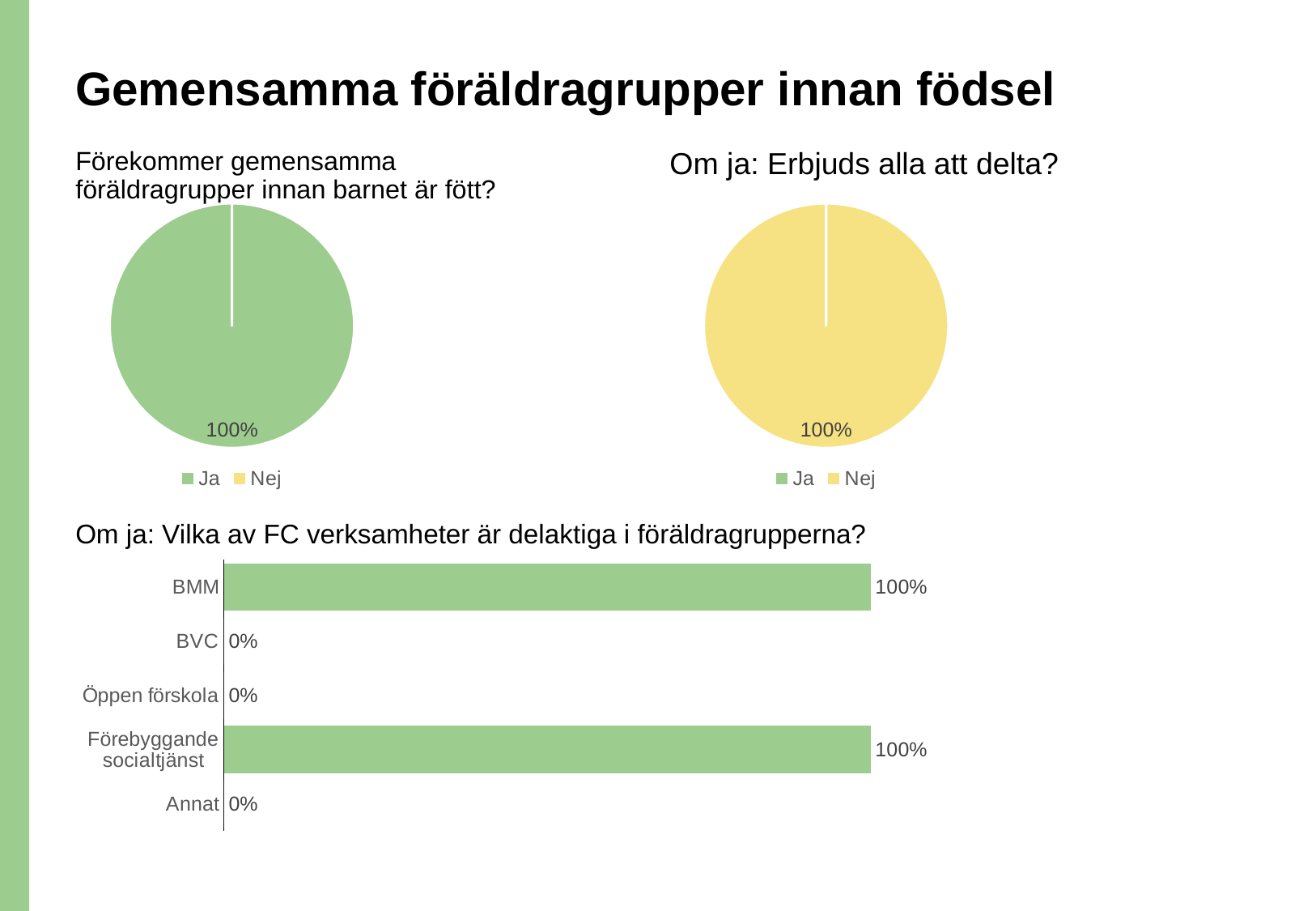
In the pie chart titled "Förekommer gemensamma föräldragrupper innan barnet är fött?", what share does the Ja slice have? 100% In the pie chart titled "Förekommer gemensamma föräldragrupper innan barnet är fött?", how many entries does the legend list? 2 What kind of chart is the chart titled "Om ja: Erbjuds alla att delta?"? pie chart In the bar chart titled "Om ja: Vilka av FC verksamheter är delaktiga i föräldragrupperna?", what is the difference between BMM and Annat? 100% In the pie chart titled "Om ja: Erbjuds alla att delta?", what share does the Nej slice have? 100% In the bar chart titled "Om ja: Vilka av FC verksamheter är delaktiga i föräldragrupperna?", how many categories are shown? 5 In the pie chart titled "Om ja: Erbjuds alla att delta?", which category makes up the whole pie? Nej In the bar chart titled "Om ja: Vilka av FC verksamheter är delaktiga i föräldragrupperna?", what is the value for BMM? 100% What kind of chart is the chart titled "Om ja: Vilka av FC verksamheter är delaktiga i föräldragrupperna?"? bar chart In the bar chart titled "Om ja: Vilka av FC verksamheter är delaktiga i föräldragrupperna?", which is larger, BMM or Öppen förskola? BMM In the bar chart titled "Om ja: Vilka av FC verksamheter är delaktiga i föräldragrupperna?", what is the value for Förebyggande socialtjänst? 100% In the bar chart titled "Om ja: Vilka av FC verksamheter är delaktiga i föräldragrupperna?", what is the value for BVC? 0%